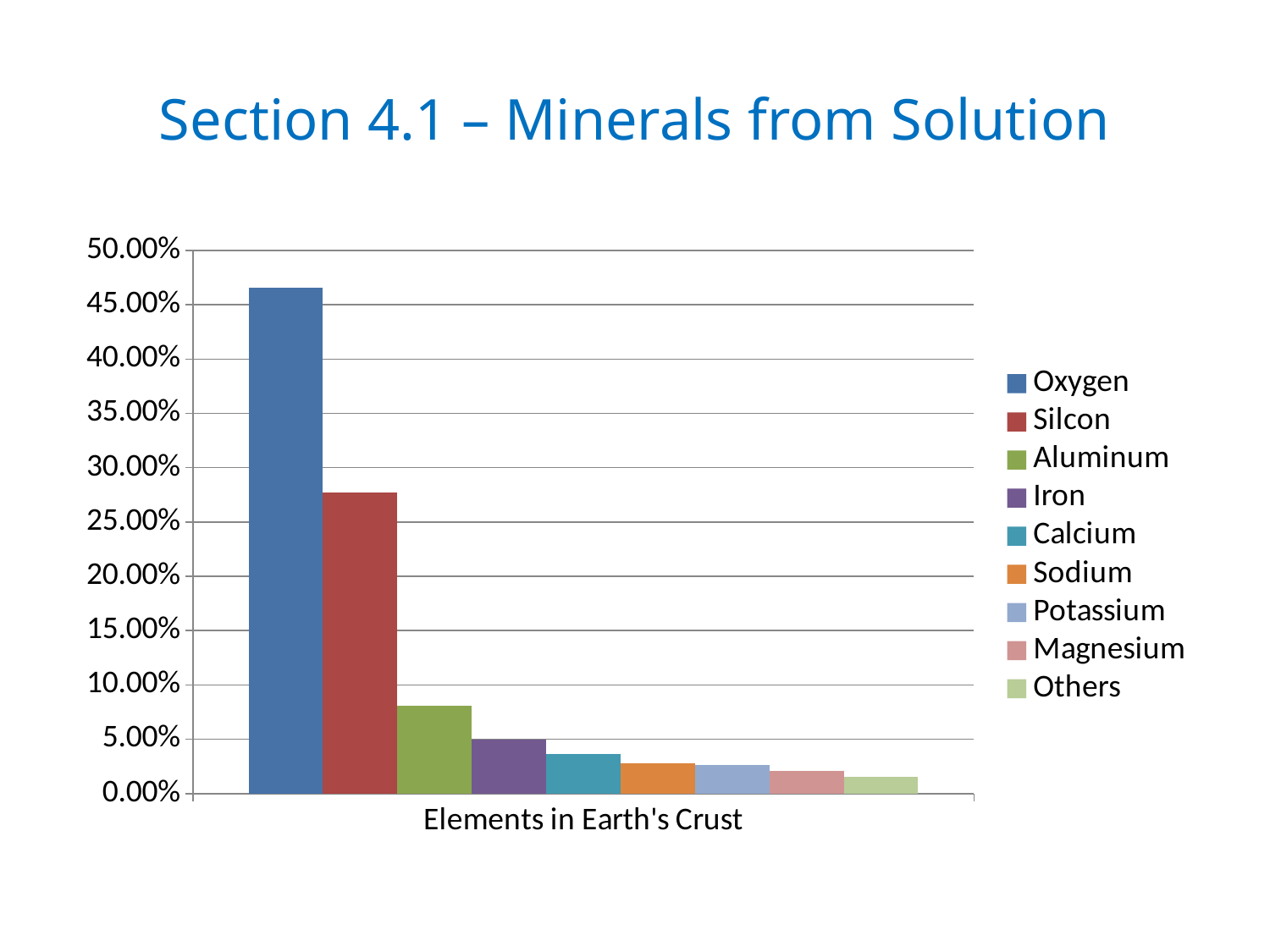
Which is larger, the value for Silicon or the value for Aluminum? Silicon Is the value for Silicon greater or less than 30.00%? less Which is larger, the value for Iron or the value for Sodium? Iron Which element has the highest value in the chart? Oxygen Is the value for Calcium greater or less than 5.00%? less Is the value for Oxygen greater or less than 45.00%? greater What is the label shown below the x axis of the chart? Elements in Earth's Crust What kind of chart is shown on the slide? bar chart Which legend entry has the lowest value in the chart? Others How many series does the legend list? 9